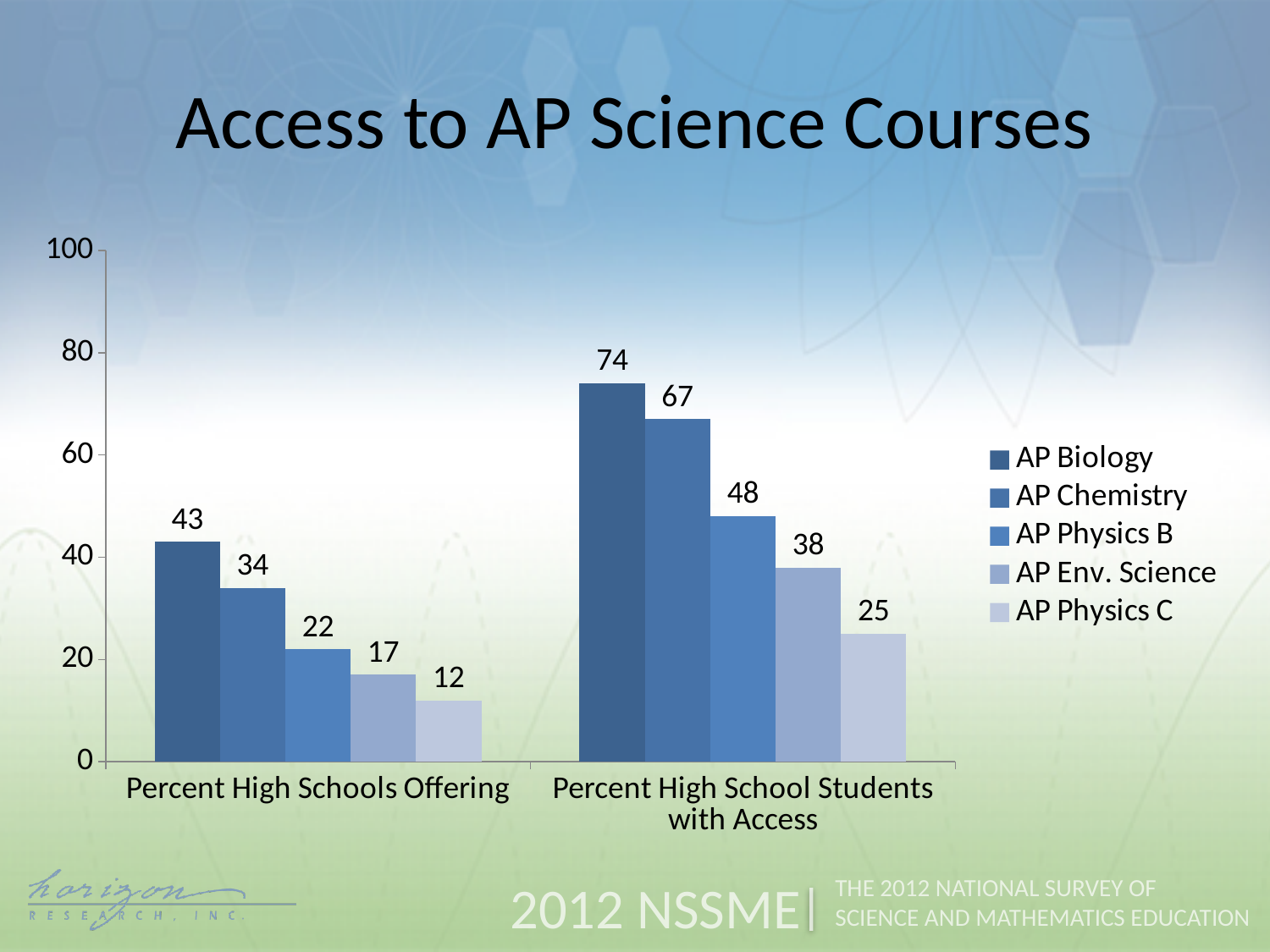
Which is larger: AP Physics B in Percent High Schools Offering or AP Physics C in Percent High School Students with Access? AP Physics C in Percent High School Students with Access What is the difference between the AP Chemistry values in the two categories? 33 Which series has the highest value in the Percent High School Students with Access category? AP Biology How many series does the legend list? 5 What is the difference between the AP Biology and AP Chemistry values in the Percent High School Students with Access category? 7 Which series has the lowest value in the Percent High Schools Offering category? AP Physics C What kind of chart is shown on the slide? Bar chart What is the value for AP Physics C in the Percent High School Students with Access category? 25 What is the title of the slide? Access to AP Science Courses What is the value for AP Env. Science in the Percent High Schools Offering category? 17 What is the value for AP Biology in the Percent High Schools Offering category? 43 How many categories are shown on the x axis? 2